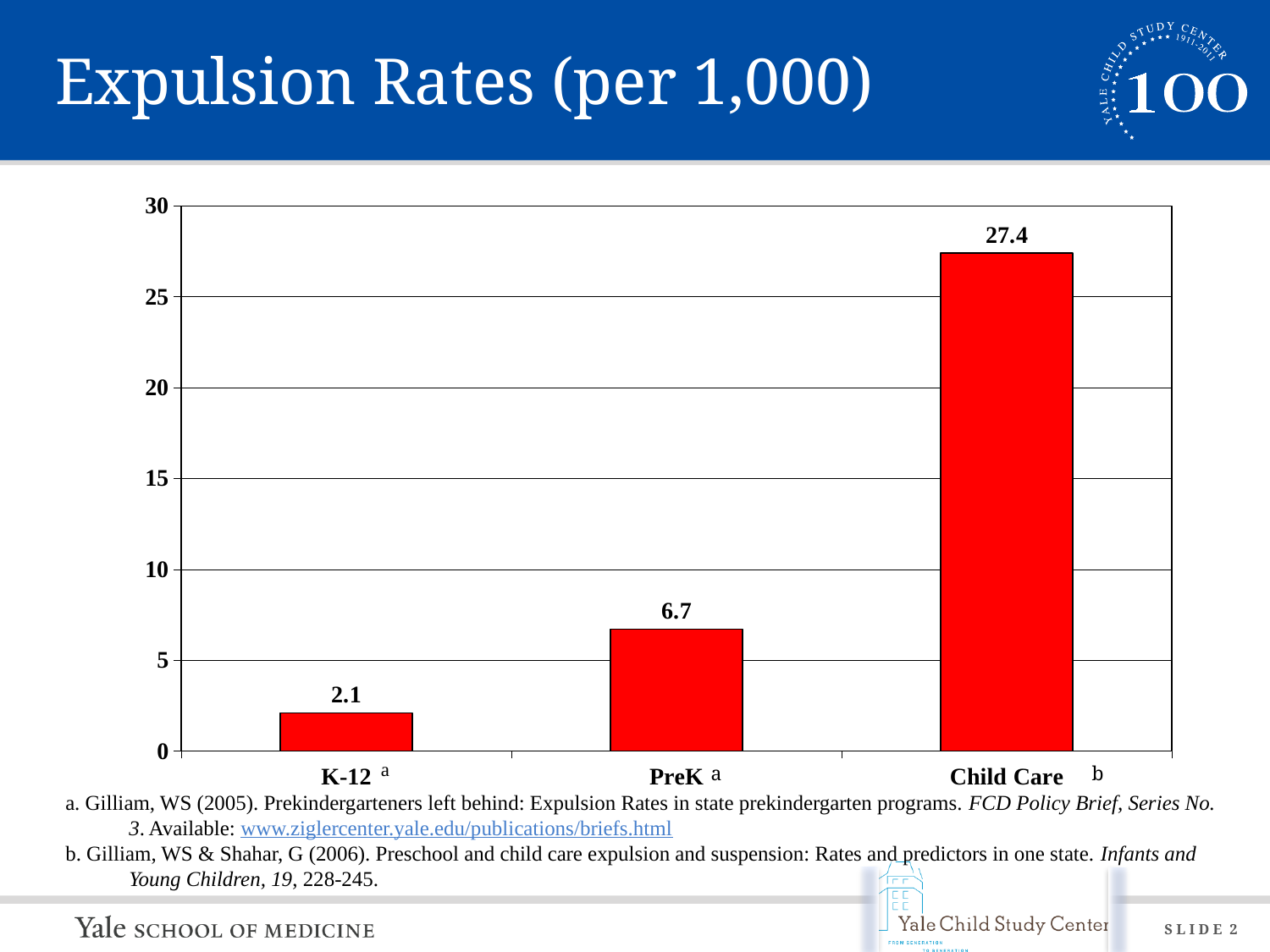
Is the value for Child Care greater or less than 25? greater Which category has the highest expulsion rate? Child Care What is the title of the slide? Expulsion Rates (per 1,000) What is the expulsion rate per 1,000 for K-12? 2.1 What is the difference between the PreK and K-12 expulsion rates? 4.6 What is the difference between the Child Care and PreK expulsion rates? 20.7 What is the expulsion rate per 1,000 for PreK? 6.7 Which category has the lowest expulsion rate? K-12 What kind of chart is shown on the slide? bar chart Which has a higher expulsion rate, PreK or K-12? PreK What is the expulsion rate per 1,000 for Child Care? 27.4 How many categories are shown on the chart? 3